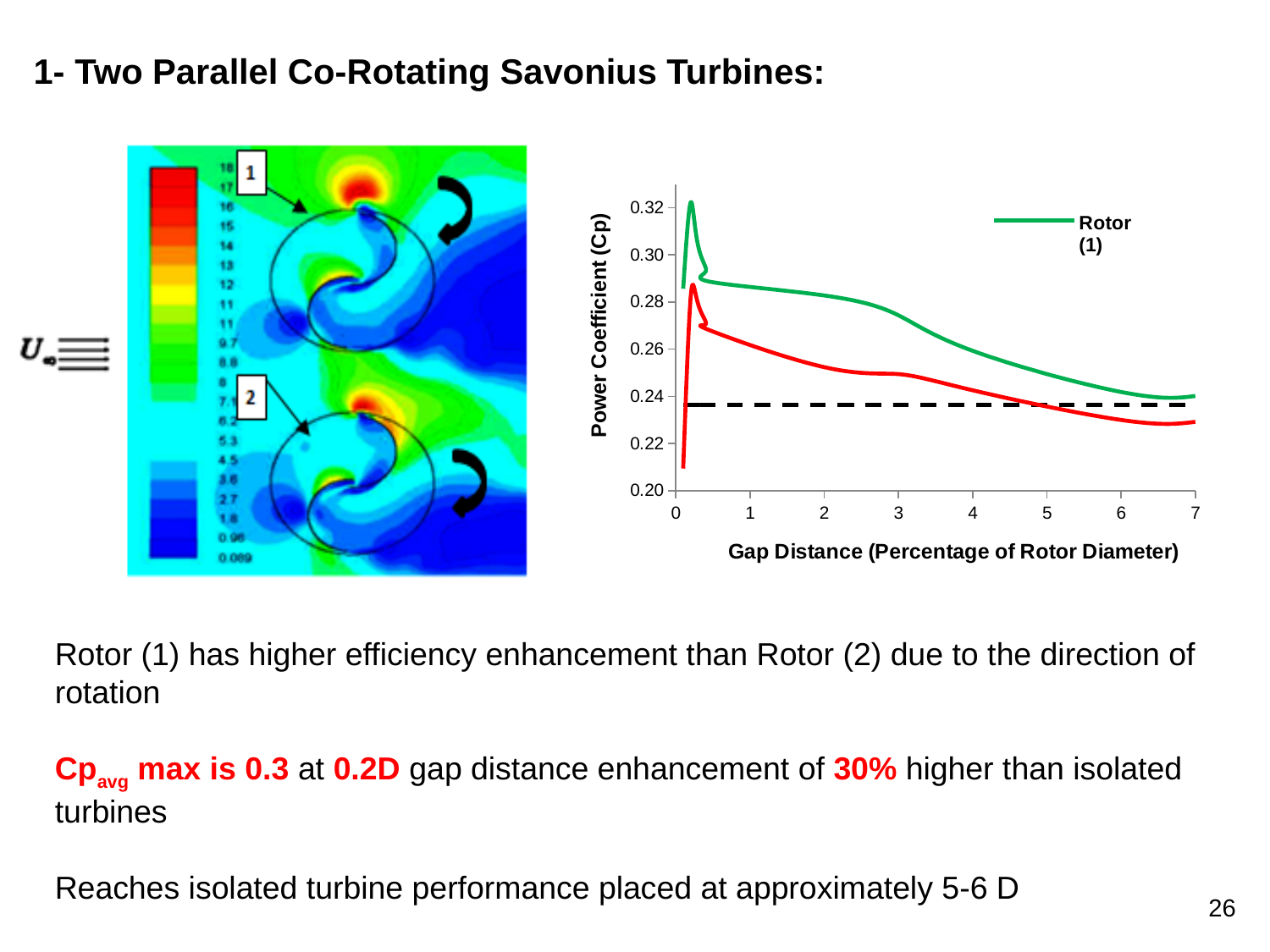
In the line chart, is the Power Coefficient of the red line at a gap distance of 6 greater or less than 0.24? less How many series does the legend of the line chart list? 1 In the line chart, is the Power Coefficient of the green Rotor (1) line at a gap distance of 3 greater or less than 0.26? greater What is the title of the x axis of the line chart? Gap Distance (Percentage of Rotor Diameter) What is the highest value shown on the y axis of the line chart? 0.32 What is the title of the y axis of the line chart? Power Coefficient (Cp) In the line chart, is the Power Coefficient of the green Rotor (1) line at a gap distance of 1 greater or less than 0.26? greater In the line chart, at a gap distance of 4, which line has the higher Power Coefficient, the green Rotor (1) line or the red line? the green Rotor (1) line What kind of chart is shown on the right of the slide? line chart In the line chart, does the red line rise or fall as the gap distance increases from 1 to 6? fall In the line chart, does the green Rotor (1) line rise or fall as the gap distance increases from 1 to 7? fall